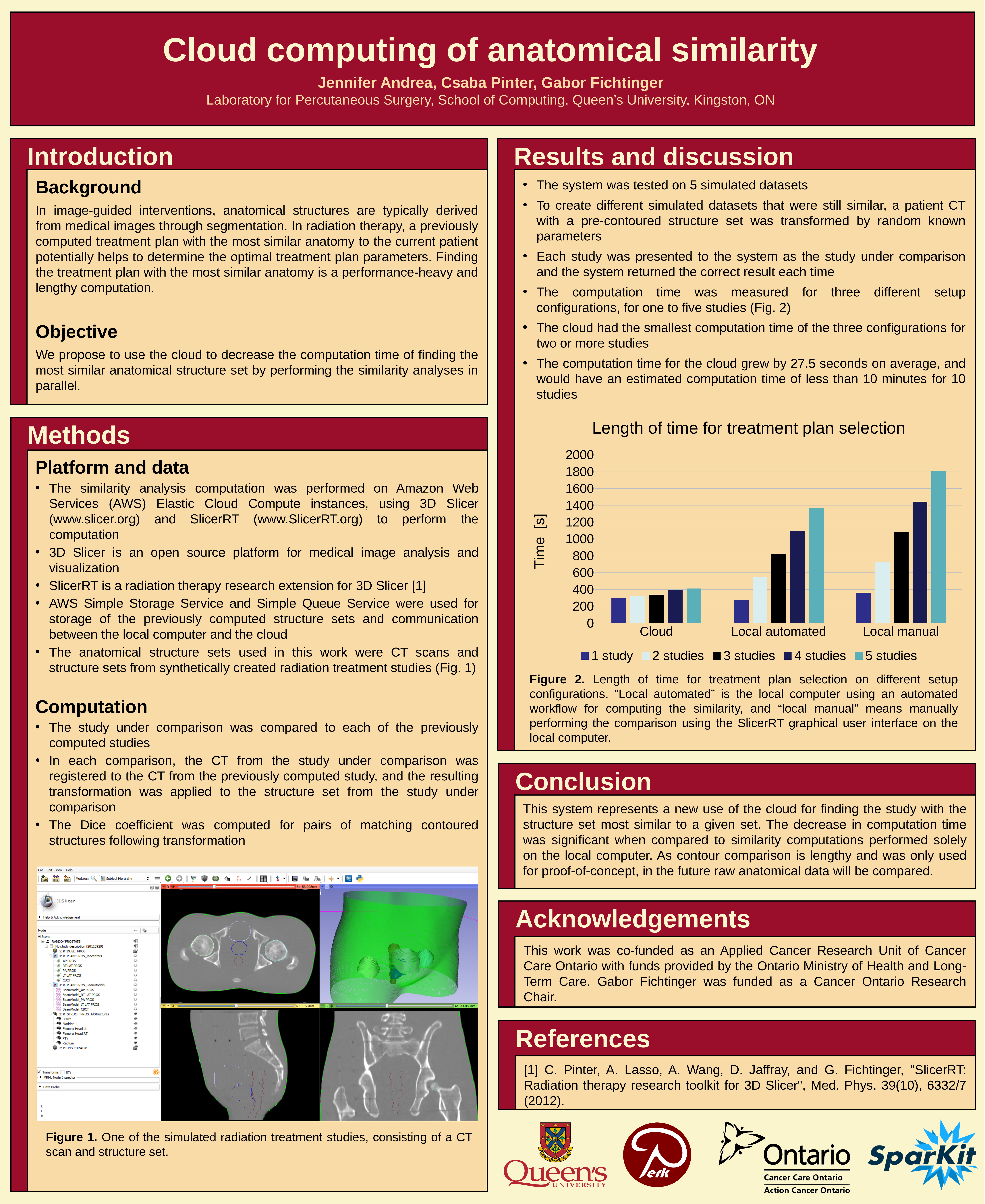
Is the value for Local automated with 3 studies greater or less than 1000? less What is the title of the chart? Length of time for treatment plan selection What kind of chart is shown under "Results and discussion"? bar chart Is the value for Local manual with 5 studies greater or less than 1600? greater Which setup configuration has the highest bar for 5 studies? Local manual For Local manual, do the bars rise or fall as the number of studies increases from 1 to 5? rise Which setup configuration has the lowest bar for 5 studies? Cloud What is the label of the y axis of the chart? Time [s] How many series does the chart's legend list? 5 For 5 studies, which is larger: the time for Cloud or for Local automated? Local automated How many setup configurations (categories) are shown on the x axis of the chart? 3 Is the value for Cloud with 5 studies greater or less than 600? less